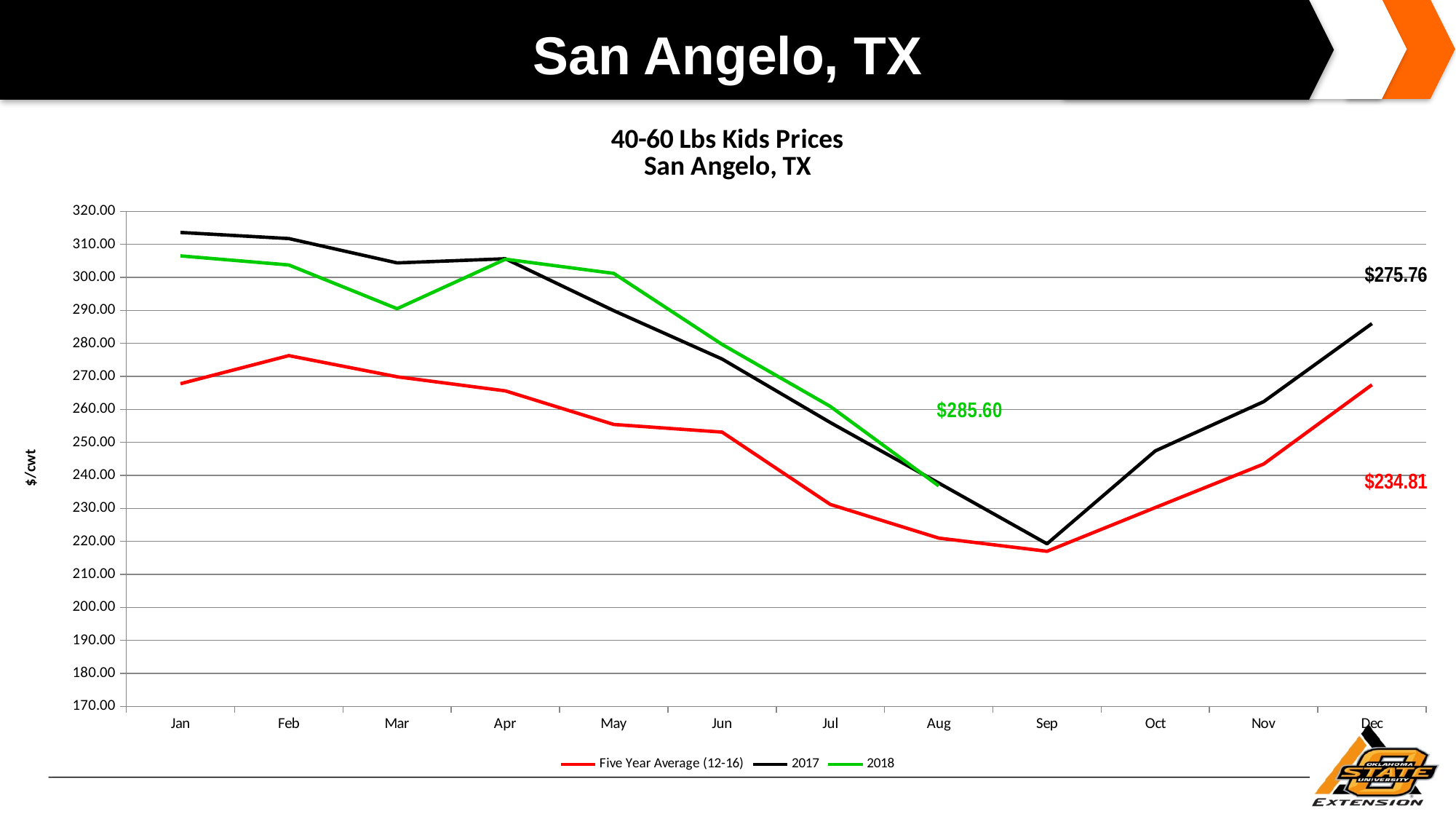
Does the Five Year Average (12-16) series rise or fall from Feb to Sep? fall Is the Five Year Average (12-16) value for Sep greater or less than 220.00? less In Mar, which series is higher: 2018 or Five Year Average (12-16)? 2018 How many months have a plotted value for the 2018 series? 8 In which month is the 2017 series at its lowest? Sep Is the 2017 value for Jan greater or less than 310.00? greater In Jan, which series is higher: 2017 or 2018? 2017 Is the 2018 value for Mar greater or less than 300.00? less How many months are shown on the x axis? 12 How many series does the legend list? 3 What kind of chart is shown on the slide? line chart In which month is the Five Year Average (12-16) series at its highest? Feb